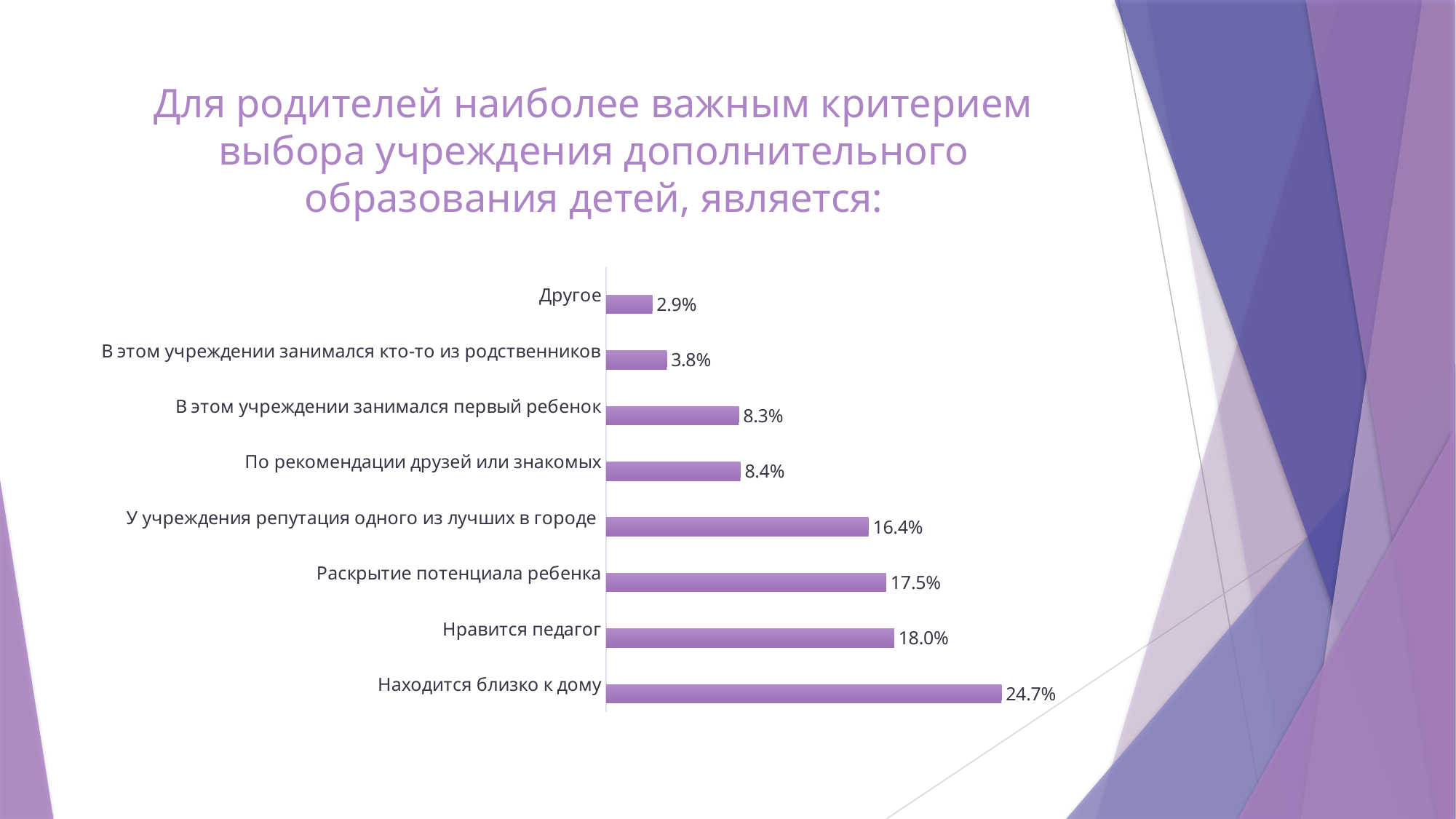
What is the value for "Находится близко к дому"? 24.7% What kind of chart is shown on the slide? Bar chart Which category has the lowest value? Другое What is the value for "Другое"? 2.9% What is the value for "У учреждения репутация одного из лучших в городе"? 16.4% Which is larger: "В этом учреждении занимался первый ребенок" or "В этом учреждении занимался кто-то из родственников"? В этом учреждении занимался первый ребенок What is the difference between "Находится близко к дому" and "Нравится педагог"? 6.7% How many categories are shown in the chart? 8 What colour are the bars in the chart? Purple What is the value for "Нравится педагог"? 18.0% Which category has the highest value? Находится близко к дому What is the difference between "Раскрытие потенциала ребенка" and "У учреждения репутация одного из лучших в городе"? 1.1%